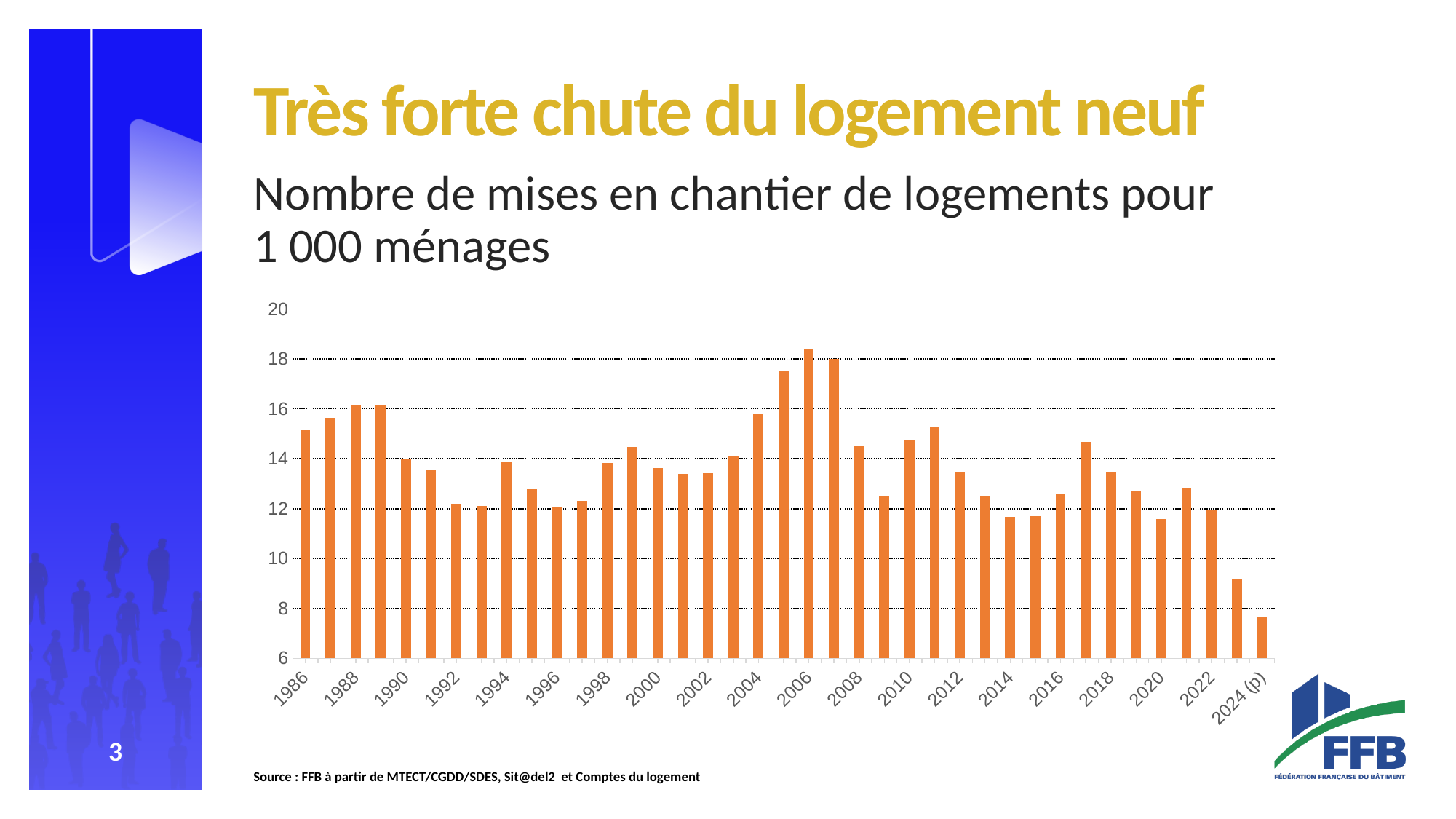
Is the value for 2006 greater or less than 16? greater Is the value for 1996 greater or less than 14? less Which year has the lowest value on the chart? 2024 (p) Which year has the highest number of housing starts per 1,000 households? 2006 Is the value for 1986 greater or less than 14? greater Which is larger, the value for 2022 or the value for 2024 (p)? 2022 What kind of chart is shown on the slide? bar chart Do the values rise or fall from 2007 to 2024 (p)? fall Which is larger, the value for 2006 or the value for 1986? 2006 What is the title of the chart on the slide? Nombre de mises en chantier de logements pour 1 000 ménages